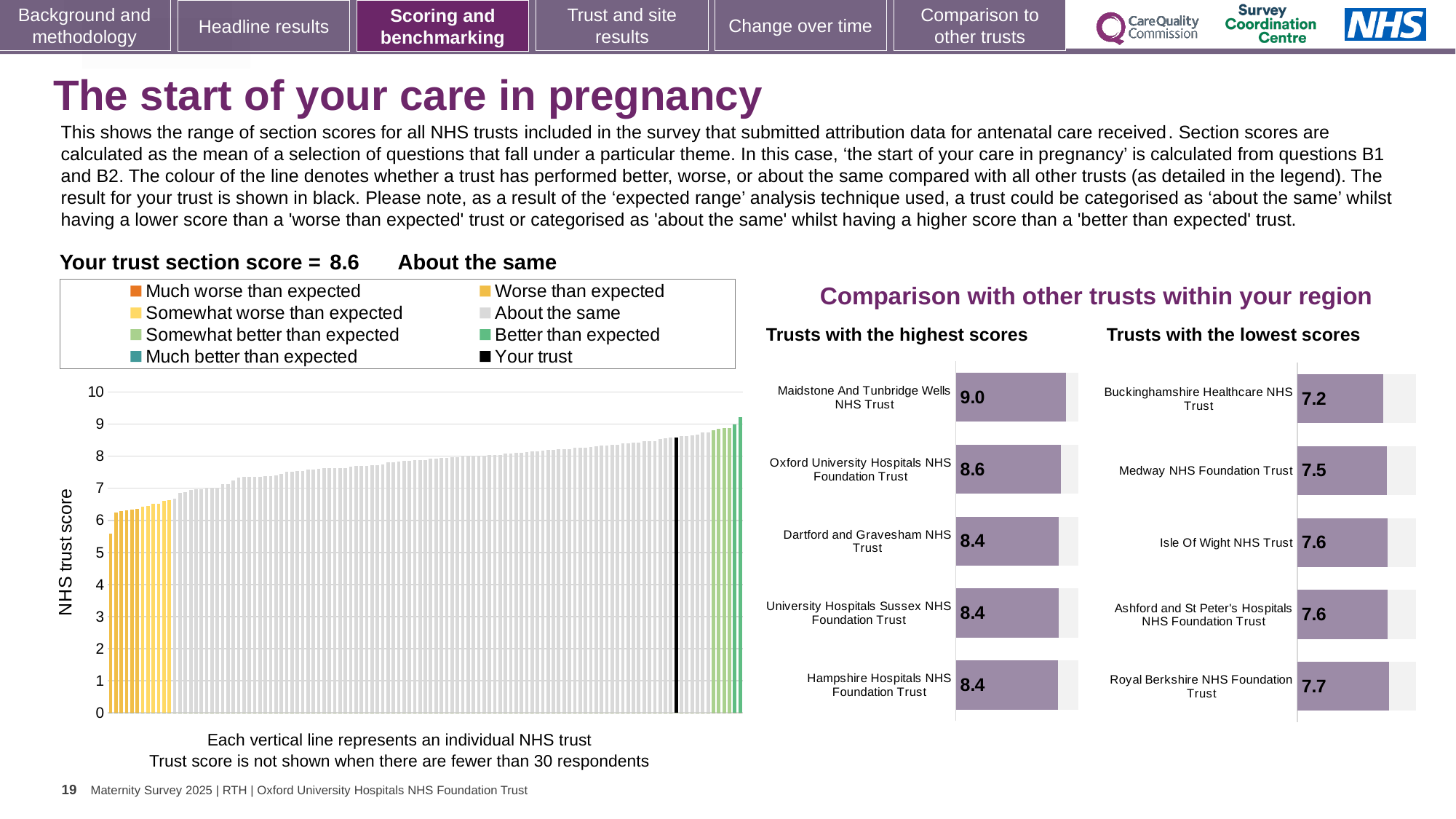
In the 'Trusts with the lowest scores' chart, which trust has the lowest score? Buckinghamshire Healthcare NHS Trust In the 'Trusts with the highest scores' chart, what is the difference between the scores of Maidstone And Tunbridge Wells NHS Trust and Oxford University Hospitals NHS Foundation Trust? 0.4 In the 'Trusts with the lowest scores' chart, what is the score for Buckinghamshire Healthcare NHS Trust? 7.2 How many entries does the legend above the main chart on the left list? 8 In the main chart on the left, is the value for the black bar (your trust) greater or less than 8? greater In the 'Trusts with the highest scores' chart, how many trusts are shown? 5 In the 'Trusts with the lowest scores' chart, which has the larger score: Medway NHS Foundation Trust or Royal Berkshire NHS Foundation Trust? Royal Berkshire NHS Foundation Trust What is the section score for your trust shown on the slide? 8.6 In the main chart on the left, do the trust scores rise or fall from left to right? rise In the 'Trusts with the highest scores' chart, which trust has the highest score? Maidstone And Tunbridge Wells NHS Trust In the 'Trusts with the lowest scores' chart, what is the score for Royal Berkshire NHS Foundation Trust? 7.7 In the 'Trusts with the highest scores' chart, what is the score for Maidstone And Tunbridge Wells NHS Trust? 9.0